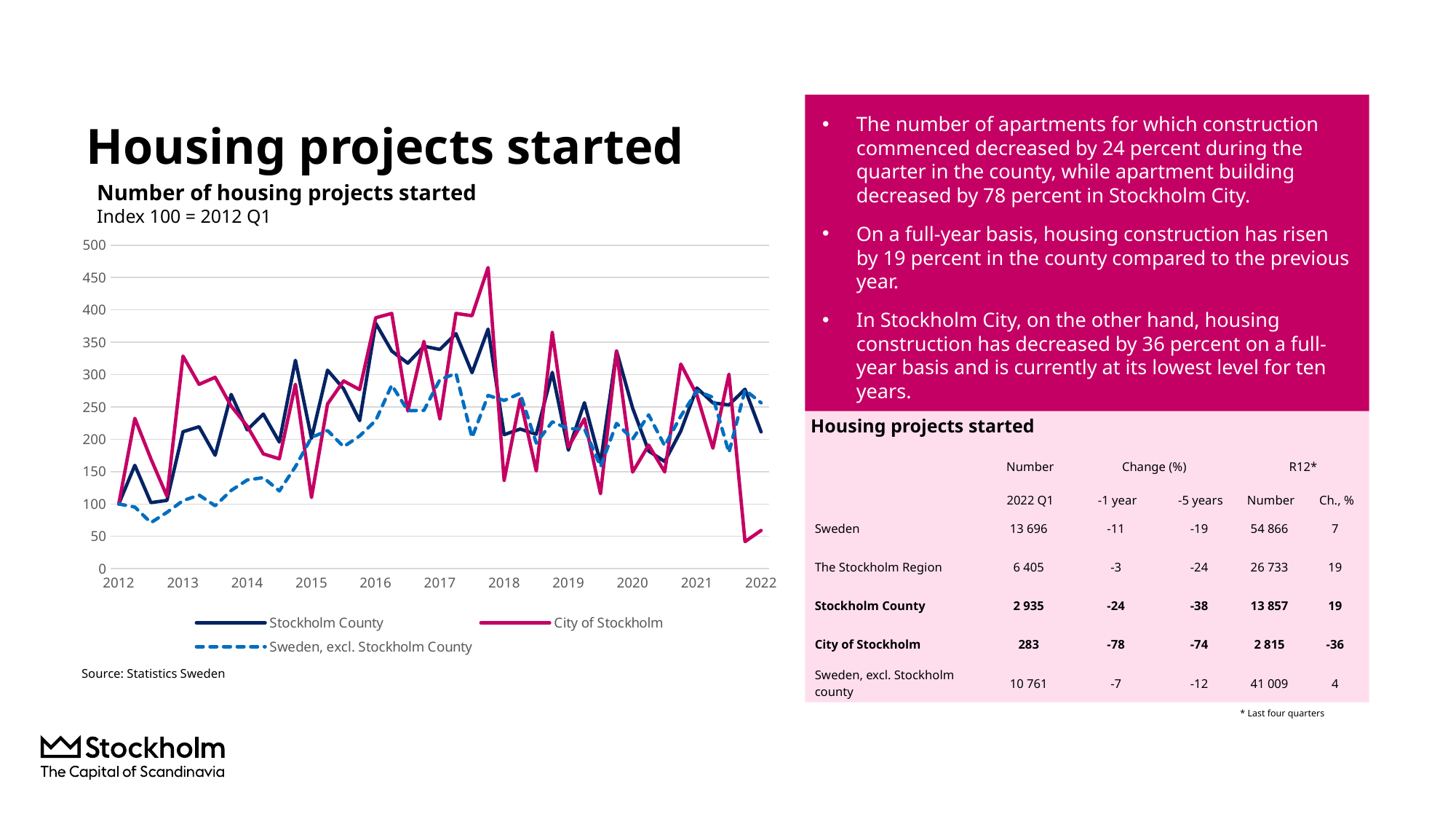
Does the City of Stockholm series rise or fall between 2021 and 2022? Fall Which series is drawn as a dashed line in the chart? Sweden, excl. Stockholm County At the end of the chart (2022), which series is lower: City of Stockholm or Stockholm County? City of Stockholm Is the value for City of Stockholm at the end of the chart (2022) greater or less than 100? less How many series does the chart legend list? 3 What is the highest value shown on the y axis? 500 Is the peak value of the City of Stockholm series (around 2017) greater or less than 450? greater Which series reaches the highest value anywhere on the chart? City of Stockholm Is the value for Stockholm County at the end of the chart (2022) greater or less than 150? greater What is the index base period stated under the chart title? Index 100 = 2012 Q1 How many year labels are shown on the x axis? 11 What kind of chart is shown on the slide? Line chart